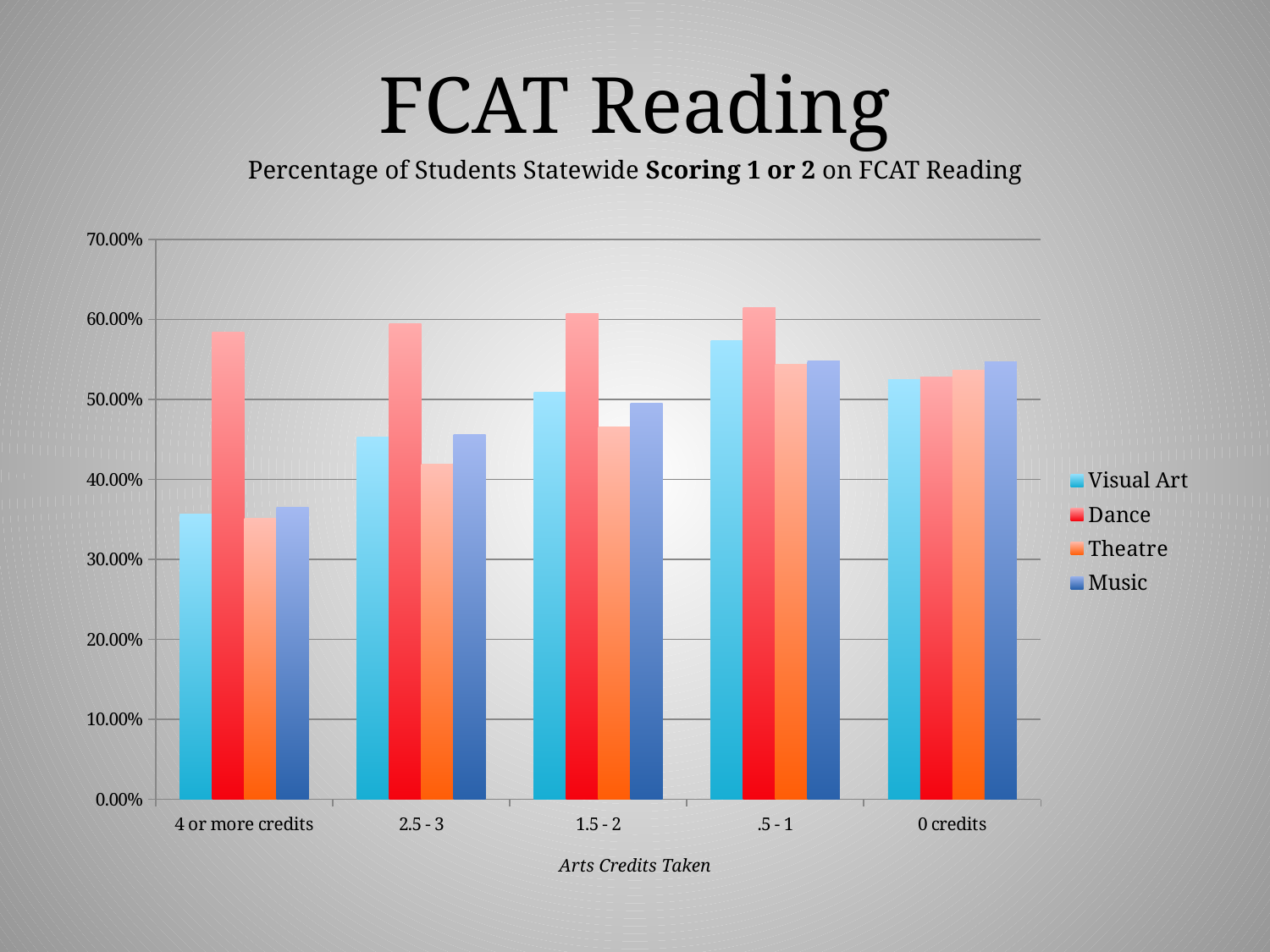
Do the Visual Art values rise or fall from 4 or more credits to .5 - 1 credits? rise Is the value for Dance at 4 or more credits greater or less than 50.00%? greater Is the value for Visual Art at 4 or more credits greater or less than 40.00%? less For which category is the Visual Art value lowest? 4 or more credits How many categories are shown along the x axis? 5 At 1.5 - 2 credits, which is larger: Dance or Visual Art? Dance What kind of chart is shown on the slide? bar chart Is the value for Theatre at 1.5 - 2 credits greater or less than 50.00%? less What is the title of the x axis? Arts Credits Taken How many series does the legend list? 4 Which series has the highest value at 4 or more credits? Dance